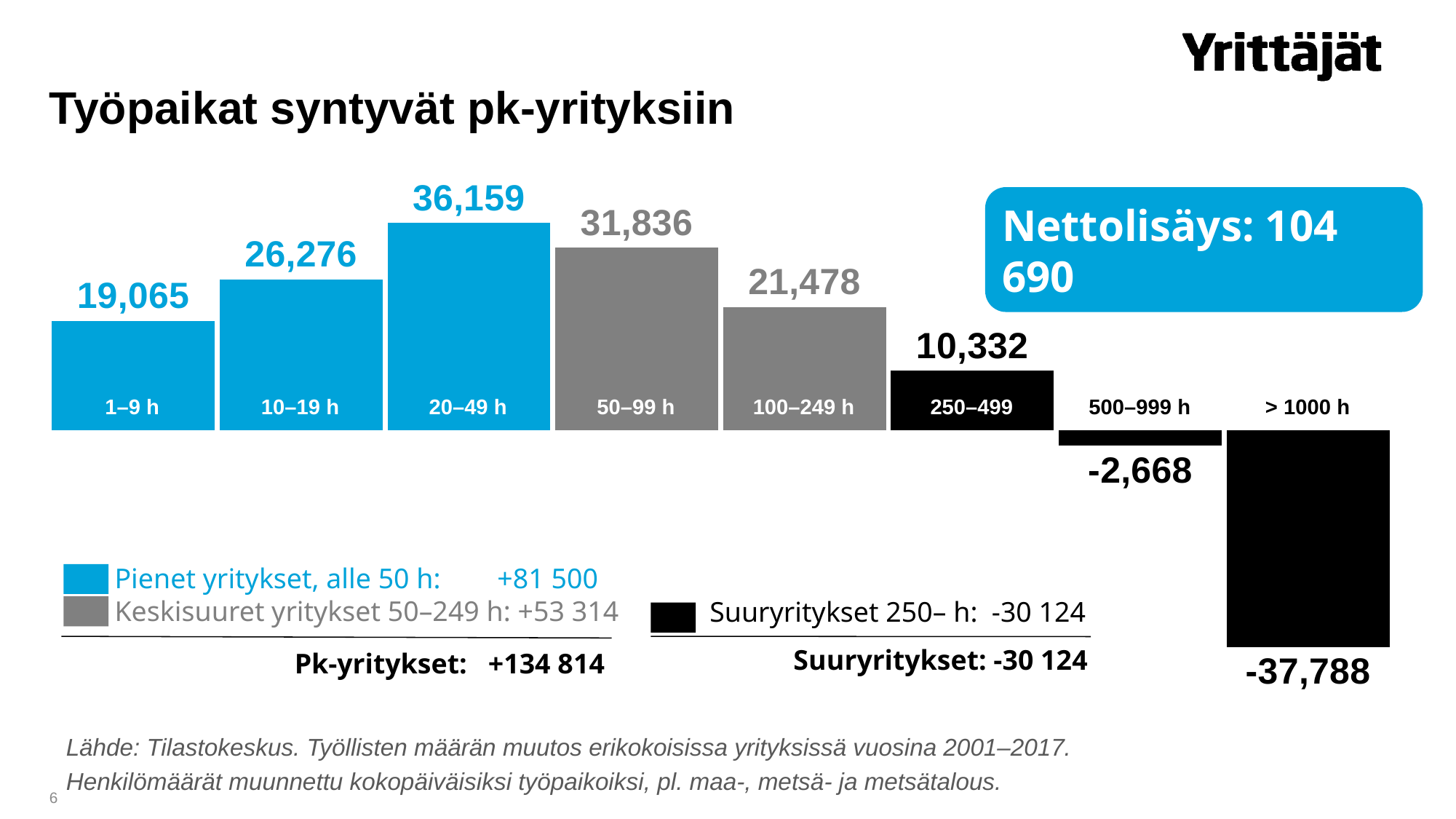
Do the values rise or fall from the 20–49 h category to the > 1000 h category? Fall What is the value for the 20–49 h category? 36,159 Which is larger, the value for 50–99 h or the value for 10–19 h? 50–99 h What kind of chart is shown on the slide? Bar chart What is the difference between the values for 20–49 h and 1–9 h? 17,094 Which category has the highest value? 20–49 h What net increase (Nettolisäys) is stated in the blue box on the slide? 104 690 Which category has the lowest value? > 1000 h What is the value for the 500–999 h category? -2,668 How many groups does the legend list? 3 How many categories are shown in the chart? 8 What is the value for the 100–249 h category? 21,478